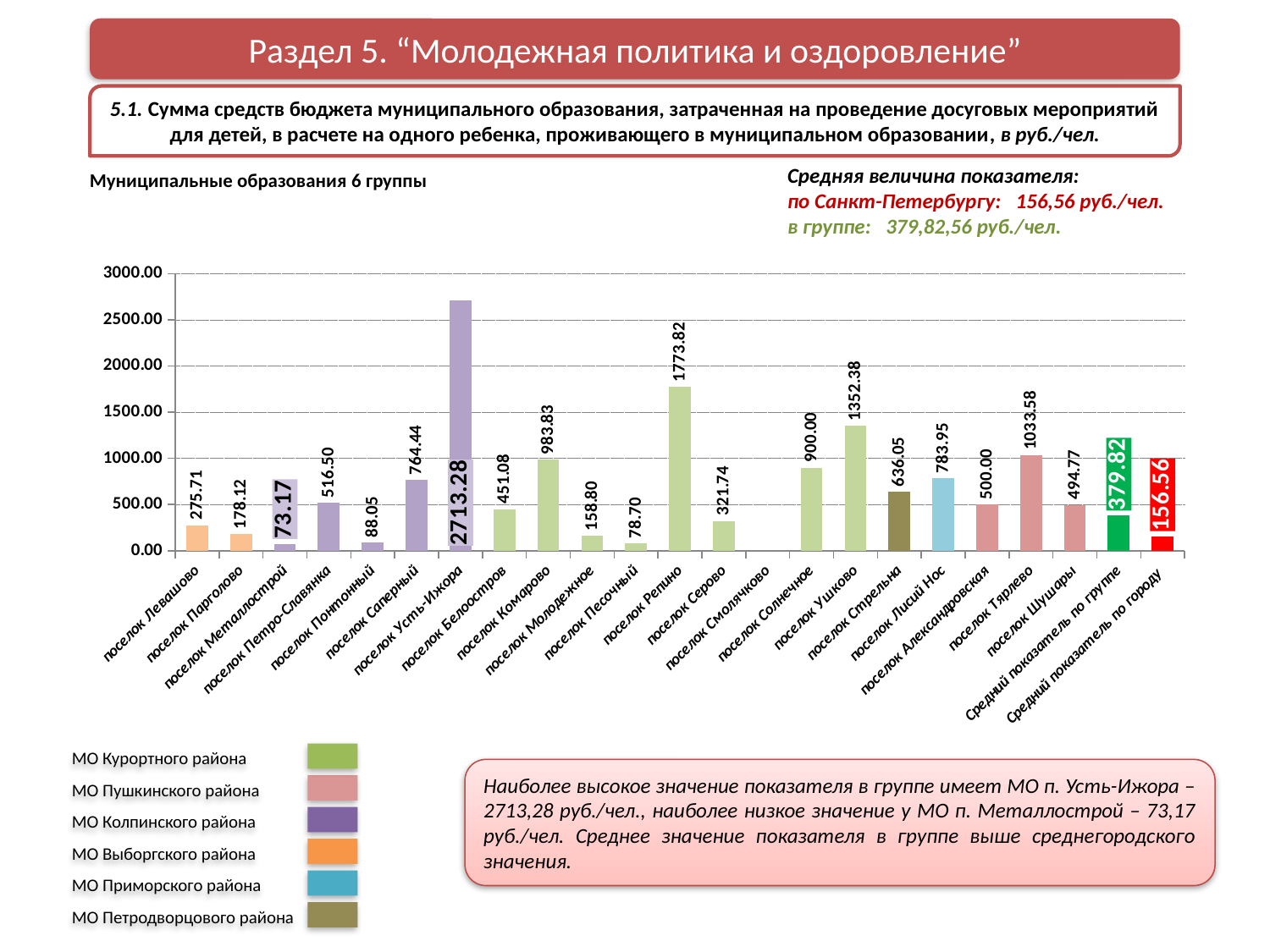
How many entries does the legend below the chart list? 6 What is the value for Средний показатель по группе? 379.82 What kind of chart is shown on the slide? bar chart What is the value for поселок Усть-Ижора? 2713.28 Which is larger, the value for поселок Комарово or поселок Солнечное? поселок Комарово How many categories are shown on the x axis of the chart? 23 What is the difference between the values for поселок Репино and поселок Ушково? 421.44 Which category has the highest value on the chart? поселок Усть-Ижора What is the value for поселок Тярлево? 1033.58 Is the value for поселок Усть-Ижора greater or less than 2500? greater What is the difference between Средний показатель по группе and Средний показатель по городу? 223.26 What is the value for поселок Репино? 1773.82